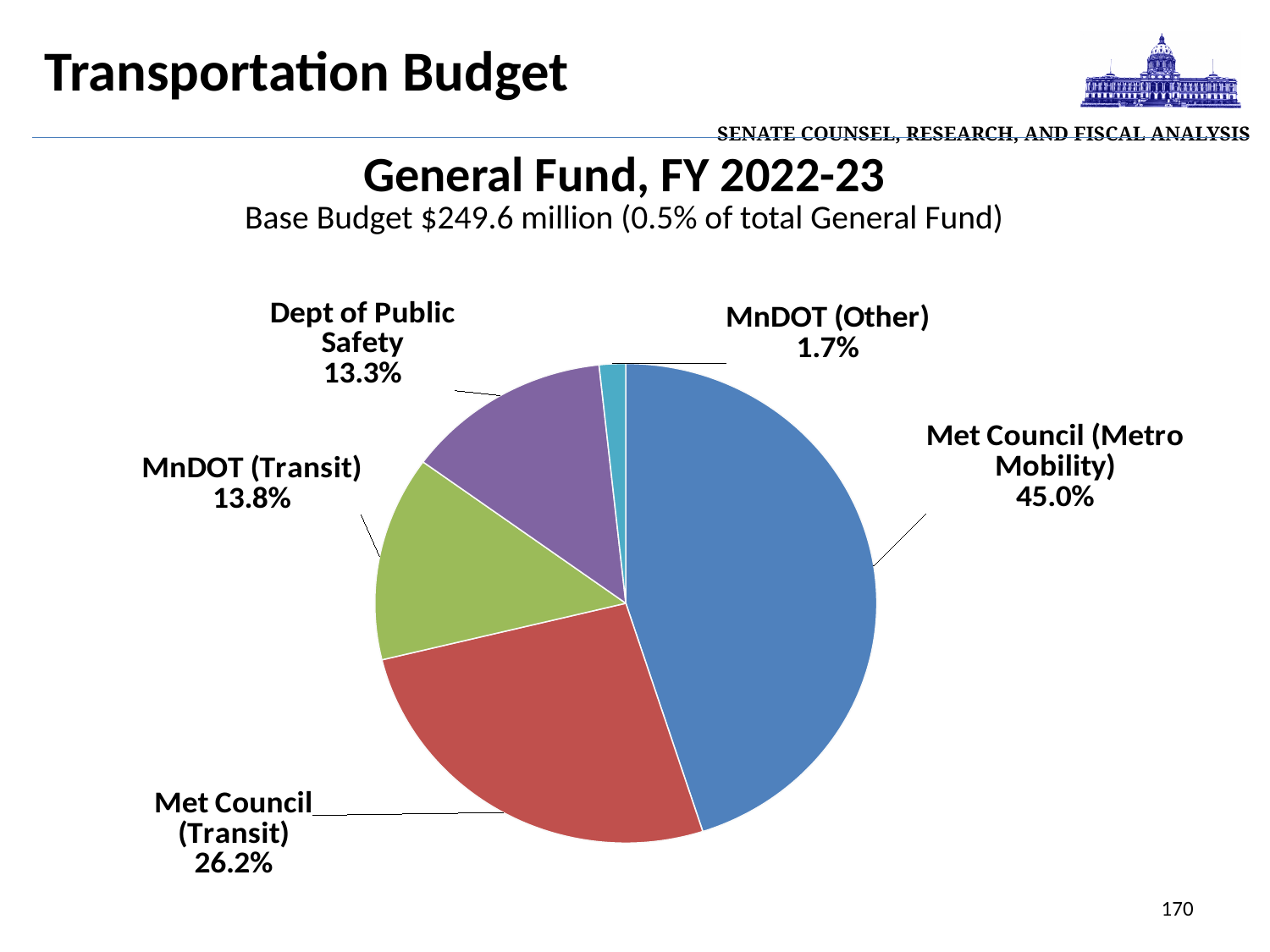
What kind of chart is shown on the slide? pie chart How many slices does the pie chart have? 5 What share of the General Fund transportation budget goes to Met Council (Metro Mobility)? 45.0% Which category has the largest share of the pie? Met Council (Metro Mobility) Which category has the smallest share of the pie? MnDOT (Other) What is the difference in percentage points between Met Council (Metro Mobility) and Met Council (Transit)? 18.8 What percentage is shown for Dept of Public Safety? 13.3% What percentage is shown for MnDOT (Transit)? 13.8% Which is larger, the share for MnDOT (Transit) or the share for Dept of Public Safety? MnDOT (Transit) What share of the pie is Met Council (Transit)? 26.2% What is the title of the chart? General Fund, FY 2022-23 What percentage is shown for MnDOT (Other)? 1.7%